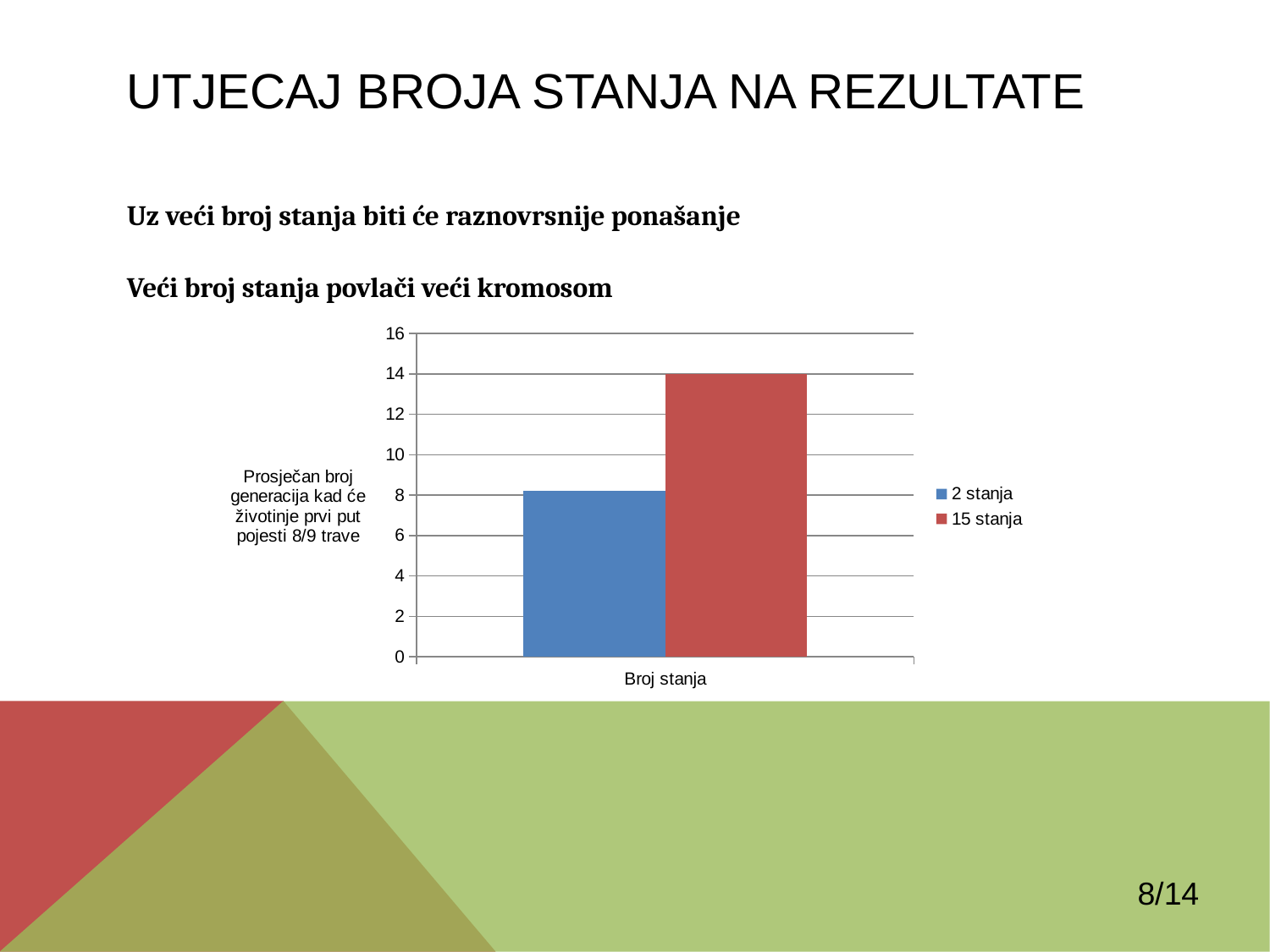
Is the value for 15 stanja greater or less than 12? greater What are the two series named in the legend? 2 stanja and 15 stanja What kind of chart is shown on the slide? bar chart Which series has the highest value? 15 stanja Which series has the lowest value? 2 stanja Which series has the higher value, 2 stanja or 15 stanja? 15 stanja What is the value for the 15 stanja series? 14 Is the value for 2 stanja greater or less than 10? less How many categories are shown on the x axis? 1 What is the label on the x axis of the chart? Broj stanja How many series does the legend list? 2